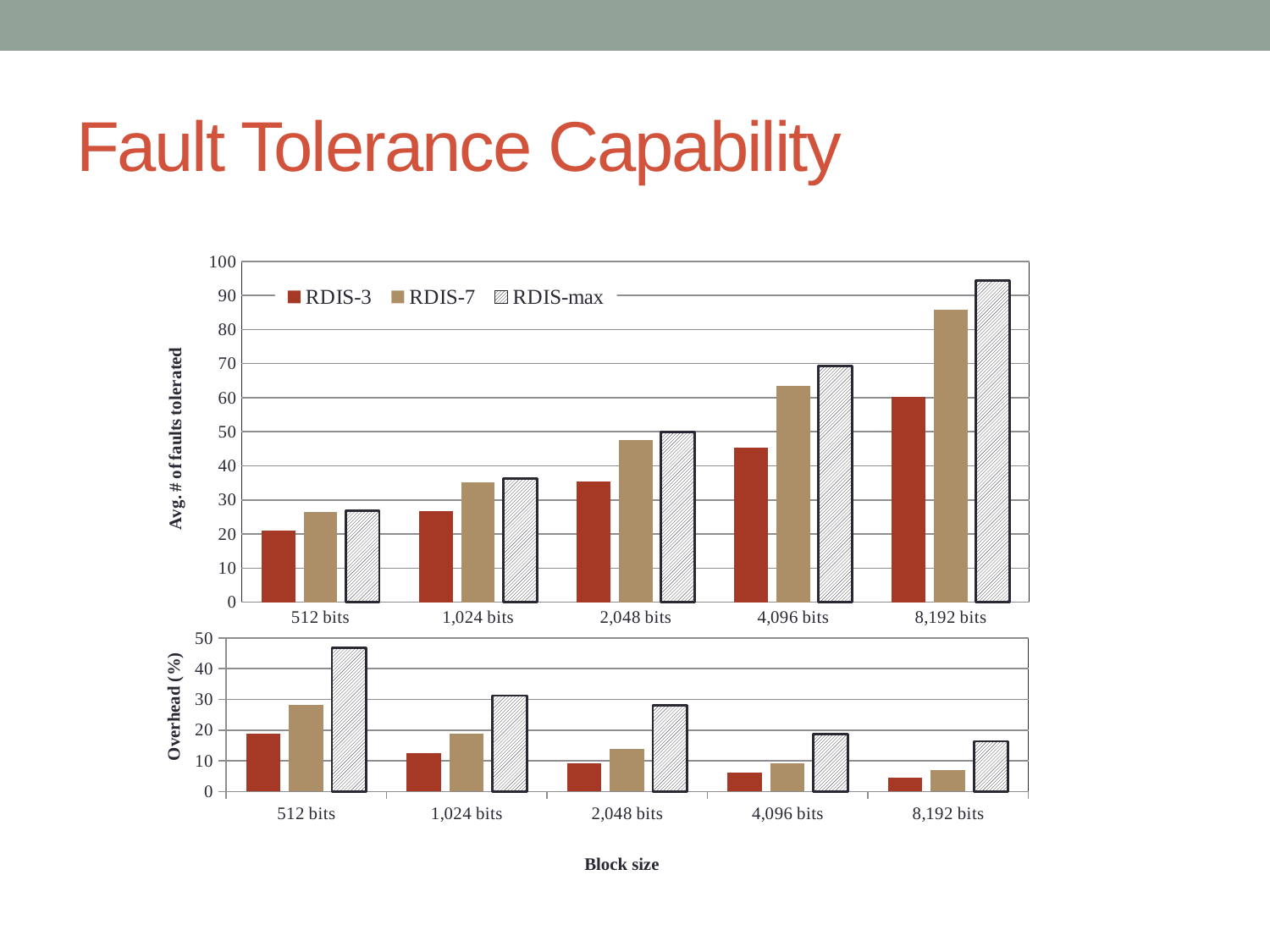
In the bottom chart (Overhead (%)), is the RDIS-max value for 512 bits greater or less than 40? greater In the bottom chart (Overhead (%)), which block size has the lowest RDIS-3 value? 8,192 bits How many series does the legend of the top chart list? 3 In the top chart (Avg. # of faults tolerated), which block size has the highest RDIS-max value? 8,192 bits In the bottom chart (Overhead (%)), do the RDIS-max values rise or fall as block size increases? fall In the top chart (Avg. # of faults tolerated), is the RDIS-max value for 8,192 bits greater or less than 90? greater In the top chart (Avg. # of faults tolerated), at 4,096 bits, which is larger: RDIS-3 or RDIS-7? RDIS-7 What is the x-axis label shared by the two charts? Block size In the top chart (Avg. # of faults tolerated), do the RDIS-7 values rise or fall as block size increases? rise In the top chart (Avg. # of faults tolerated), is the RDIS-3 value for 512 bits greater or less than 30? less What kind of chart is the top chart on the slide? bar chart How many block sizes are shown along the x axis of the bottom chart? 5